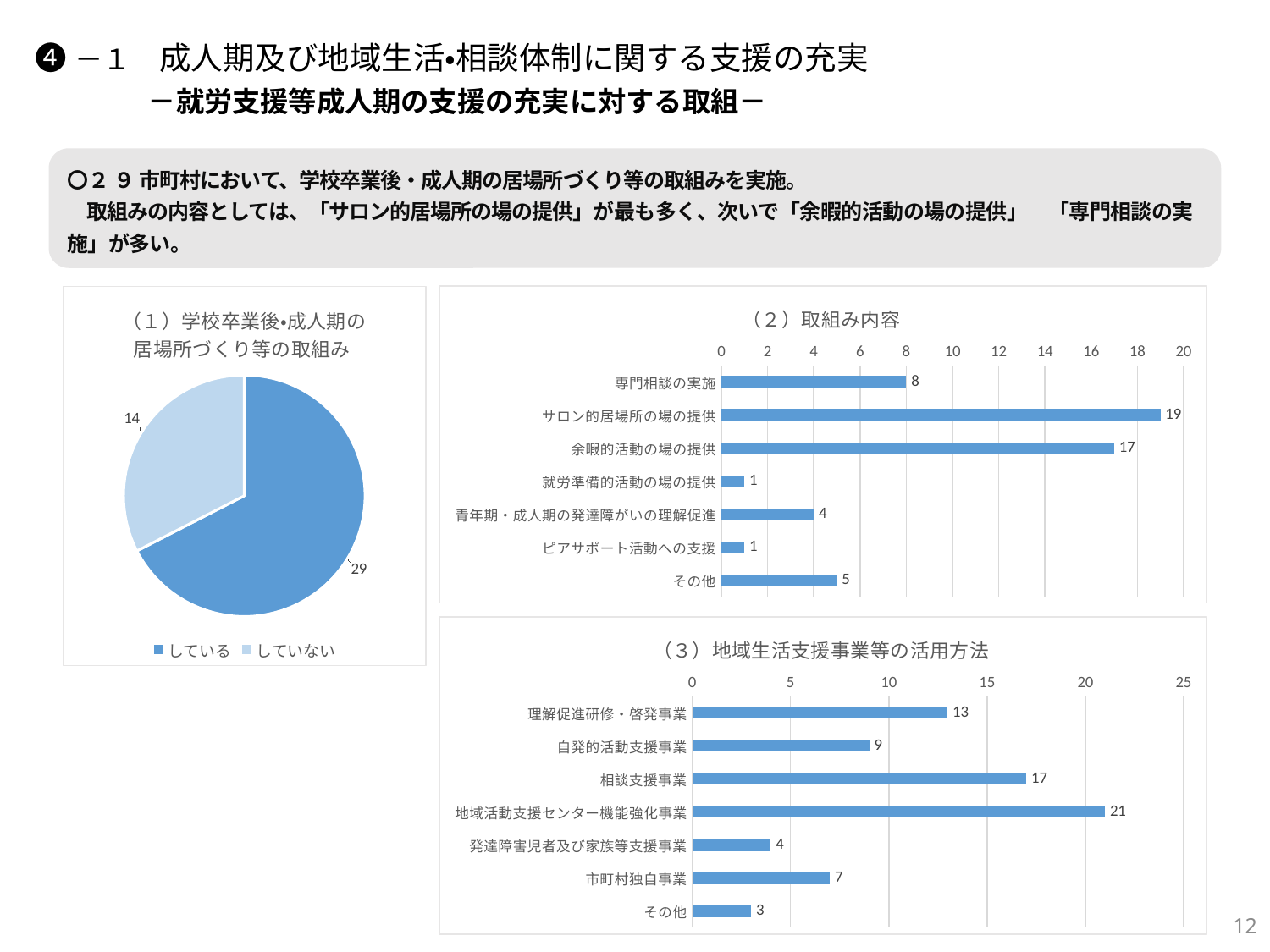
In the chart titled （３）地域生活支援事業等の活用方法, what is the value for 地域活動支援センター機能強化事業? 21 In the chart titled （３）地域生活支援事業等の活用方法, which category has the lowest value? その他 In the chart titled （１）学校卒業後•成人期の居場所づくり等の取組み, what is the difference between している and していない? 15 In the chart titled （２）取組み内容, what is the value for サロン的居場所の場の提供? 19 In the chart titled （２）取組み内容, which category has the highest value? サロン的居場所の場の提供 In the chart titled （３）地域生活支援事業等の活用方法, which is larger, 理解促進研修・啓発事業 or 自発的活動支援事業? 理解促進研修・啓発事業 In the chart titled （１）学校卒業後•成人期の居場所づくり等の取組み, what is the value for している? 29 In the chart titled （２）取組み内容, how many categories are shown? 7 In the chart titled （１）学校卒業後•成人期の居場所づくり等の取組み, what is the value for していない? 14 What kind of chart is （３）地域生活支援事業等の活用方法? Bar chart In the chart titled （２）取組み内容, what is the difference between 余暇的活動の場の提供 and 専門相談の実施? 9 What kind of chart is （１）学校卒業後•成人期の居場所づくり等の取組み? Pie chart